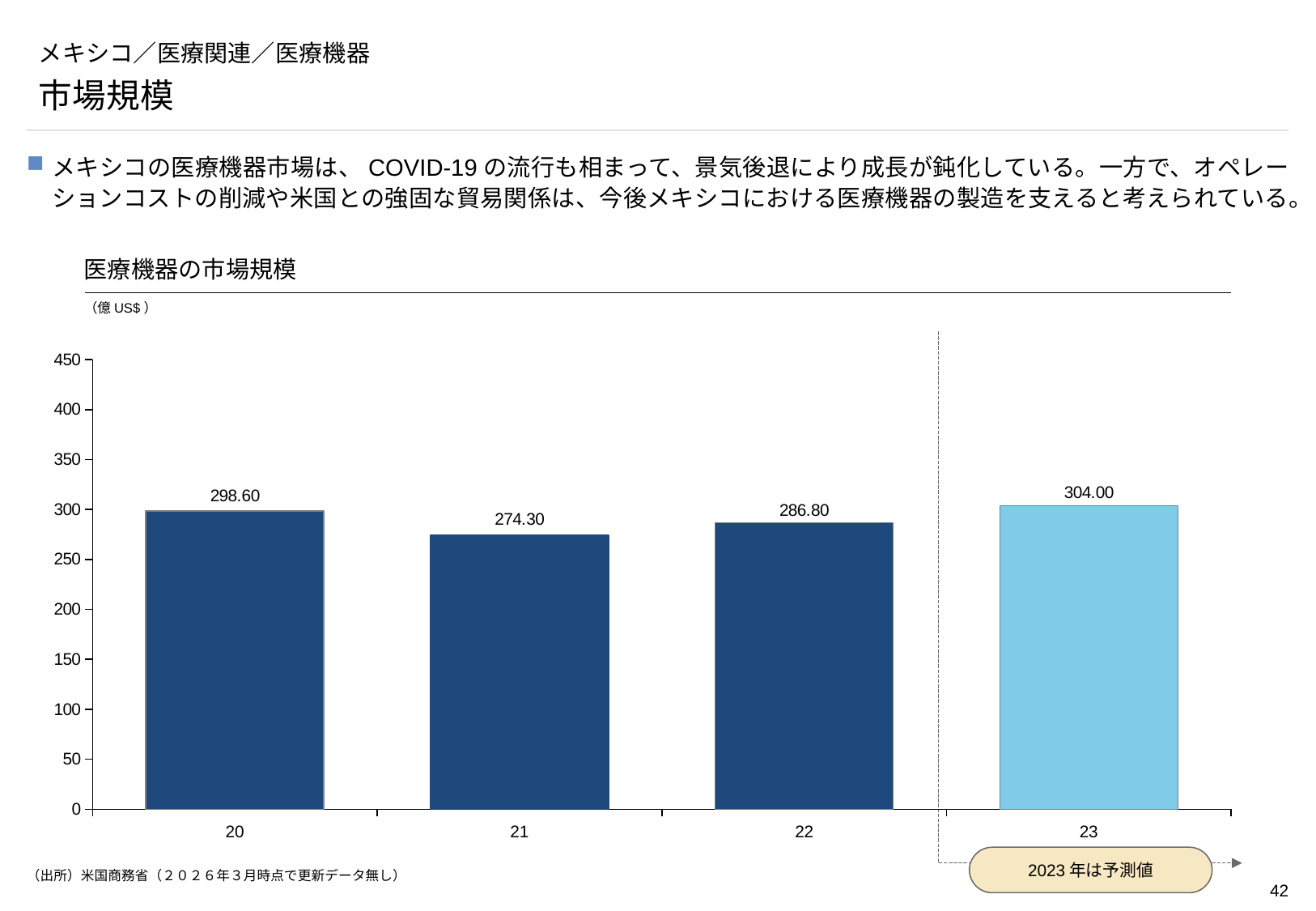
What is the value for 21 in the 医療機器の市場規模 chart? 274.30 What kind of chart is the 医療機器の市場規模 chart? bar chart How many years are shown on the x axis of the 医療機器の市場規模 chart? 4 What is the value for 22 in the 医療機器の市場規模 chart? 286.80 What is the difference between the values for 23 and 22 in the 医療機器の市場規模 chart? 17.20 What is the value for 20 in the 医療機器の市場規模 chart? 298.60 Which year has the highest value in the 医療機器の市場規模 chart? 23 What is the value for 23 in the 医療機器の市場規模 chart? 304.00 Which is larger in the 医療機器の市場規模 chart, the value for 20 or the value for 22? 20 What unit is shown for the values in the 医療機器の市場規模 chart? 億 US$ What is the difference between the values for 20 and 21 in the 医療機器の市場規模 chart? 24.30 Which year has the lowest value in the 医療機器の市場規模 chart? 21